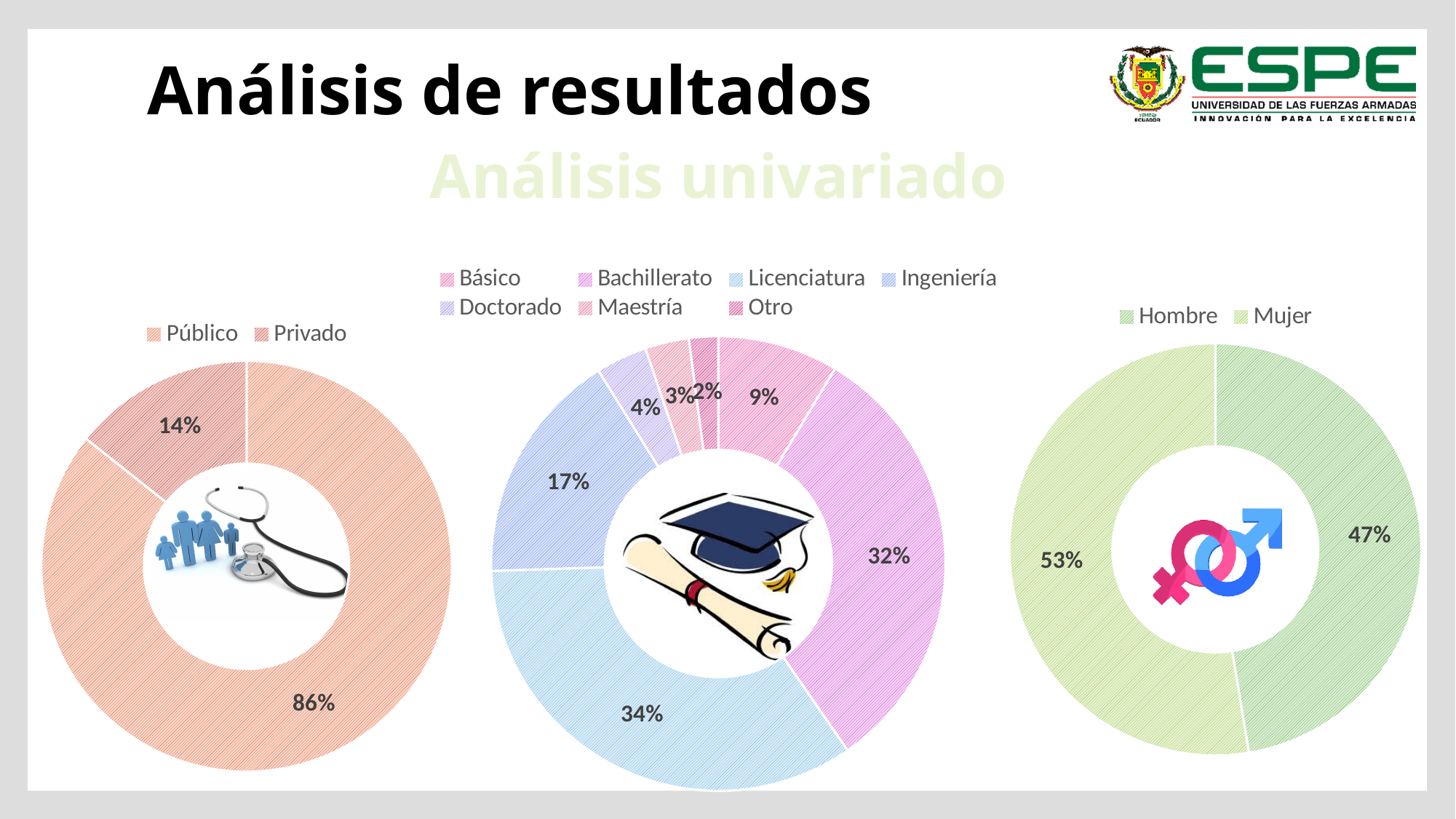
In the right chart (Hombre/Mujer), which category has the larger share? Mujer In the middle chart (education level), what percentage is Ingeniería? 17% In the middle chart (education level), which category has the smallest share? Otro In the middle chart (education level), what percentage is Licenciatura? 34% In the left chart (Público/Privado), what percentage is Privado? 14% What type of chart is the right chart (Hombre/Mujer)? Doughnut (pie) chart In the middle chart (education level), which is larger, Doctorado or Maestría? Doctorado In the left chart (Público/Privado), what percentage is Público? 86% In the middle chart (education level), what percentage is Bachillerato? 32% In the right chart (Hombre/Mujer), what percentage is Mujer? 53% In the left chart (Público/Privado), what is the difference between the Público and Privado shares? 72% In the middle chart (education level), how many categories does the legend list? 7